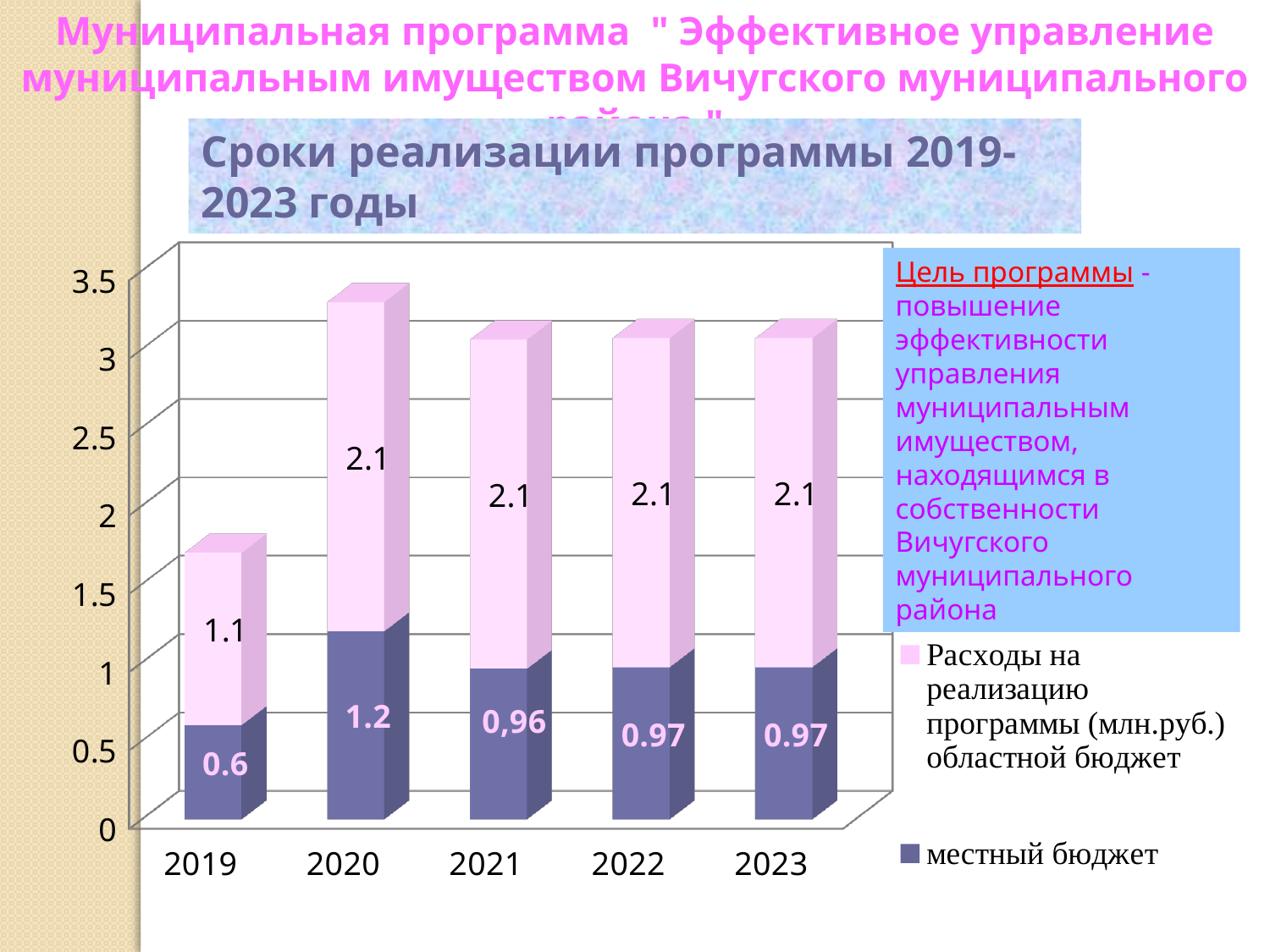
How many years are shown on the x axis? 5 What is the value for местный бюджет in 2019? 0.6 What is the total of the stacked bar for 2020? 3.3 What is the difference between the местный бюджет values for 2020 and 2019? 0.6 What is the value for областной бюджет in 2020? 2.1 What is the value for областной бюджет in 2019? 1.1 How many series does the legend list? 2 What is the value for местный бюджет in 2021? 0,96 Which is larger: the местный бюджет value for 2020 or for 2022? 2020 Which year has the lowest value for областной бюджет? 2019 What kind of chart is shown on the slide? Stacked bar chart Which year has the highest value for местный бюджет? 2020